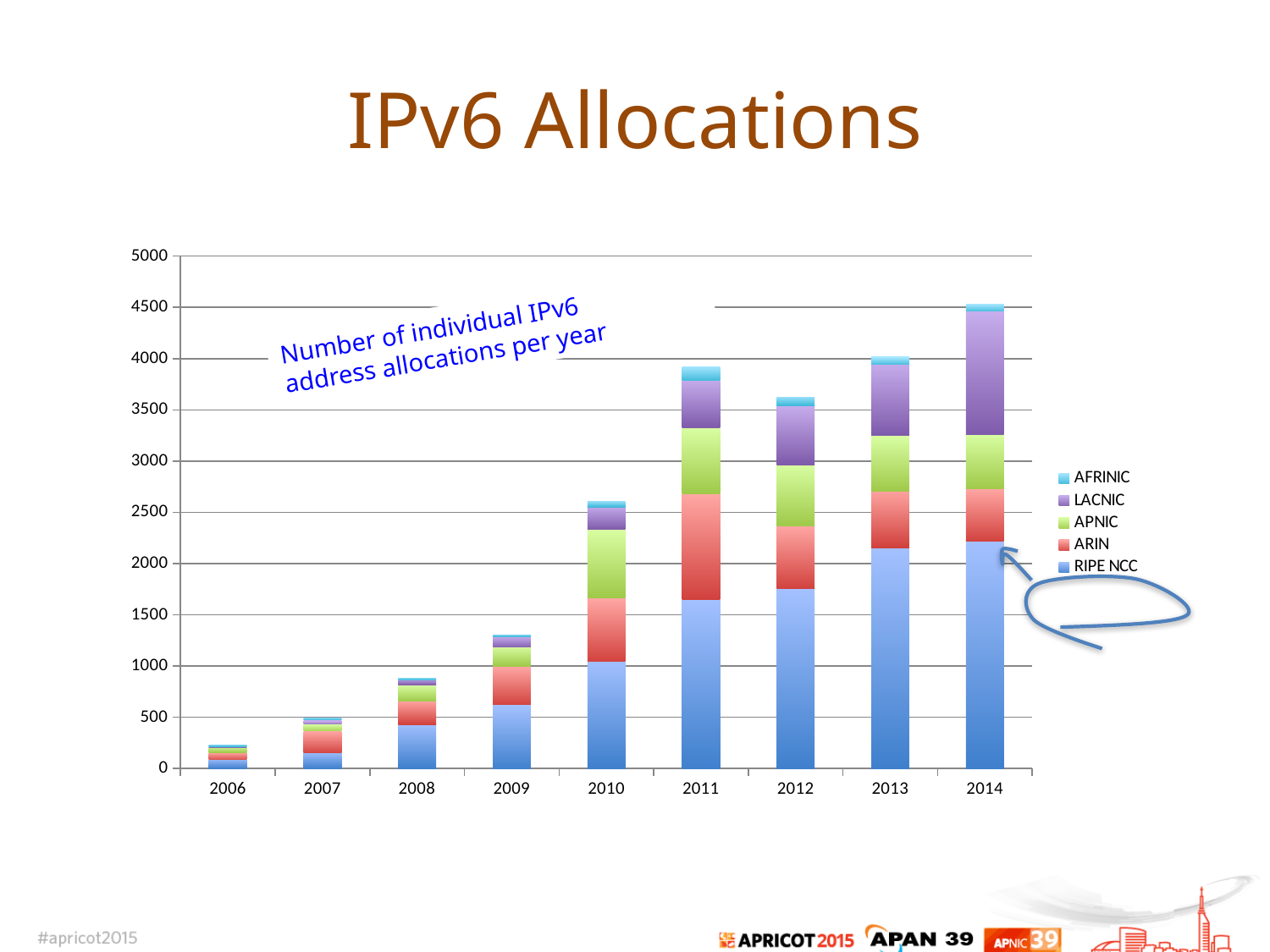
Which year has the larger total, 2011 or 2012? 2011 Which year has the highest total IPv6 allocations? 2014 Do the total allocations generally rise or fall from 2006 to 2014? rise Is the total for 2009 greater or less than 1500? less Is the total for 2006 greater or less than 500? less Is the total for 2014 greater or less than 4000? greater How many series does the chart's legend list? 5 Which year has the lowest total IPv6 allocations? 2006 Which series is listed last (at the bottom) in the chart's legend? RIPE NCC How many years are shown along the x axis of the chart? 9 What kind of chart is shown on the slide? Stacked bar chart